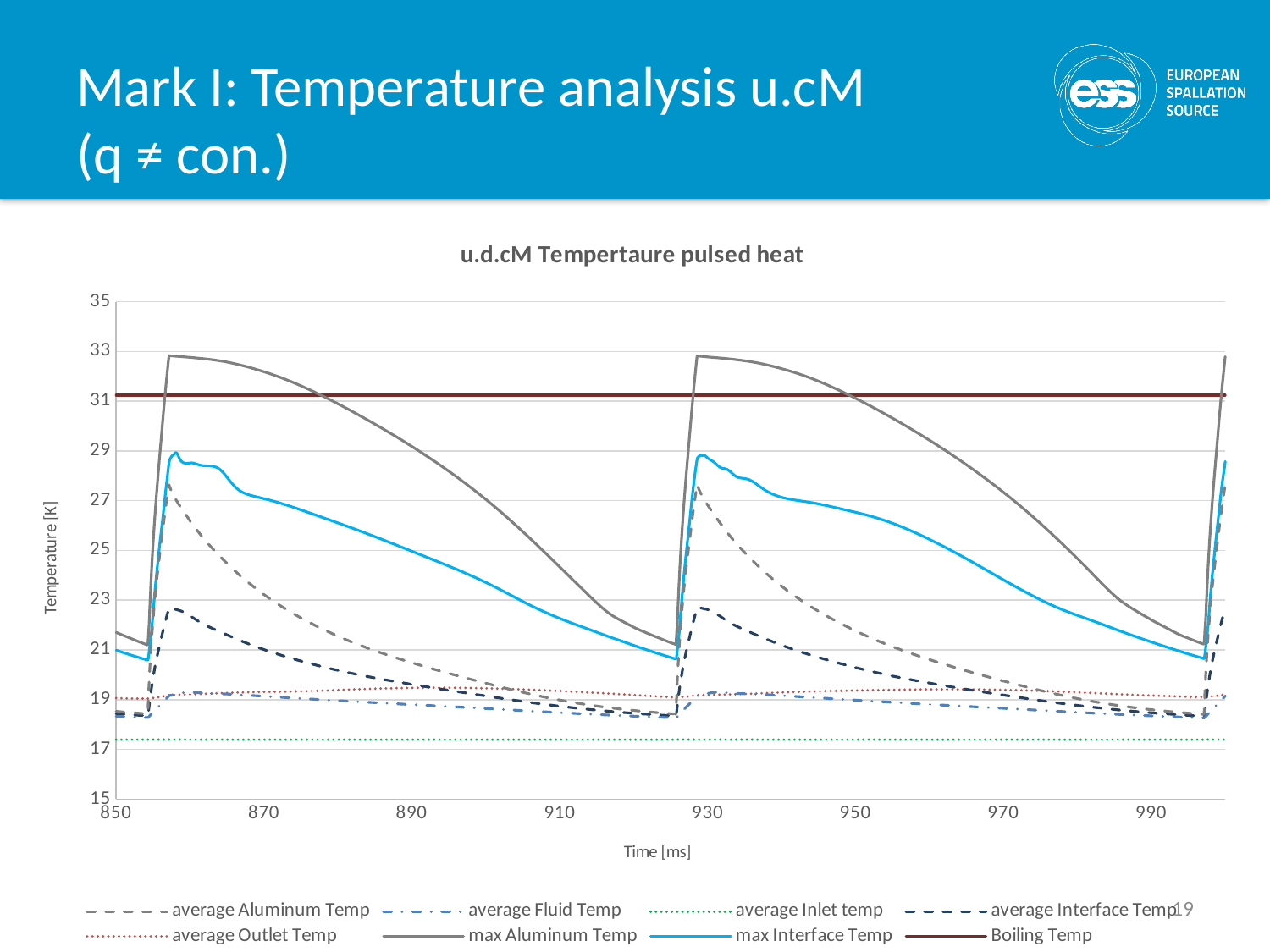
Is the peak value of max Aluminum Temp greater or less than 31? greater What kind of chart is shown on the slide? line chart What is the title of the chart? u.d.cM Tempertaure pulsed heat Which series reaches a higher peak, max Aluminum Temp or max Interface Temp? max Aluminum Temp Between 870 ms and 910 ms, does max Aluminum Temp rise or fall? fall Which is higher, the Boiling Temp line or the peak of max Interface Temp? Boiling Temp How many series does the legend list? 8 What is the label of the vertical axis? Temperature [K] Is the Boiling Temp line greater or less than 29? greater Is the peak value of max Interface Temp greater or less than 27? greater Which series has the lowest values across the whole time range? average Inlet temp